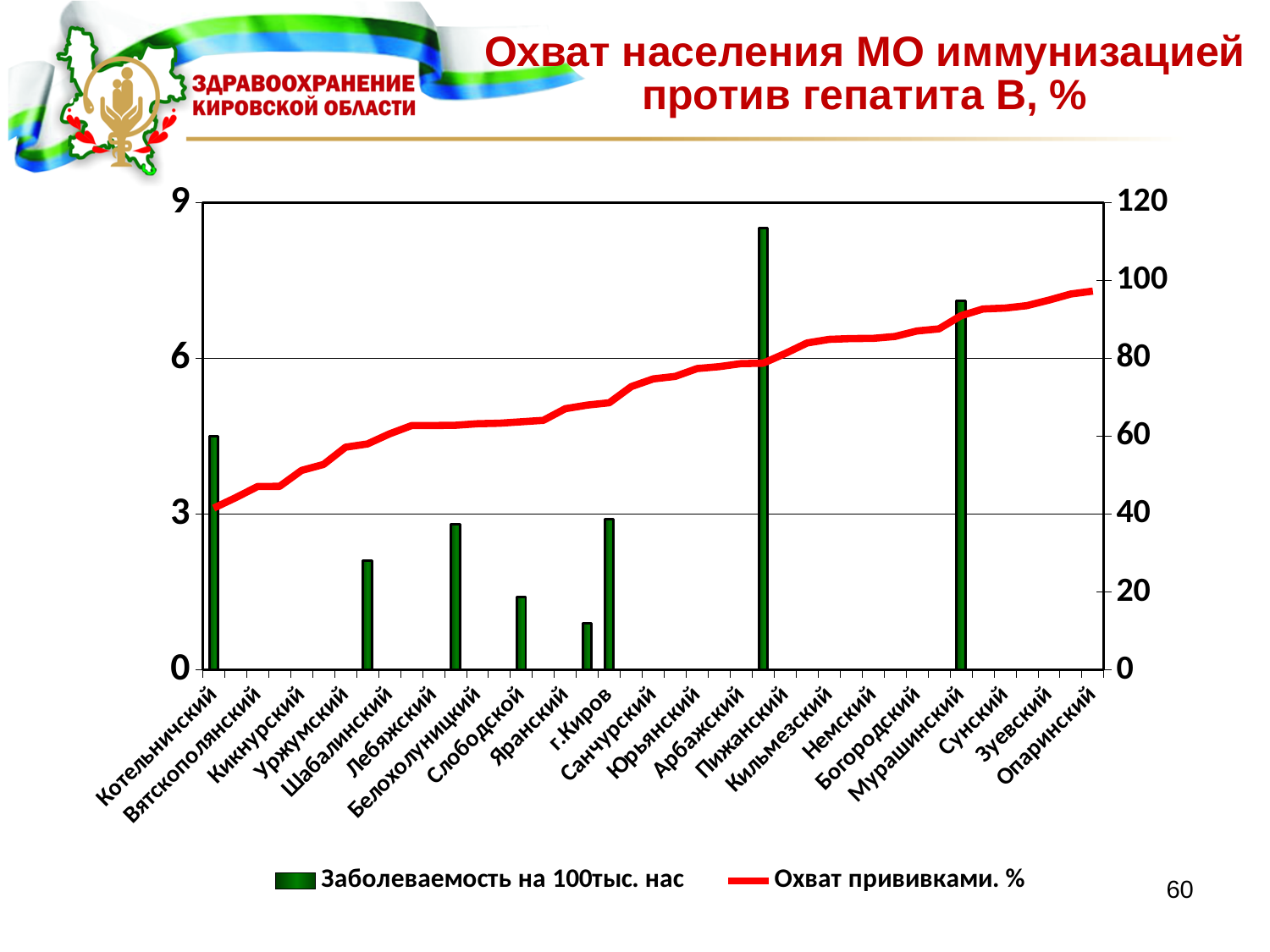
Is the Охват прививками. % value for Опаринский greater or less than 80? greater Is the Заболеваемость на 100тыс. нас value for Слободской greater or less than 3? less What kind of chart is shown on the slide? A combined bar and line chart How many series does the legend list? 2 What is the title of the chart? Охват населения МО иммунизацией против гепатита В, % Is the Заболеваемость на 100тыс. нас value for Котельничский greater or less than 3? greater Does the Охват прививками. % line rise or fall from left to right along the x axis? It rises